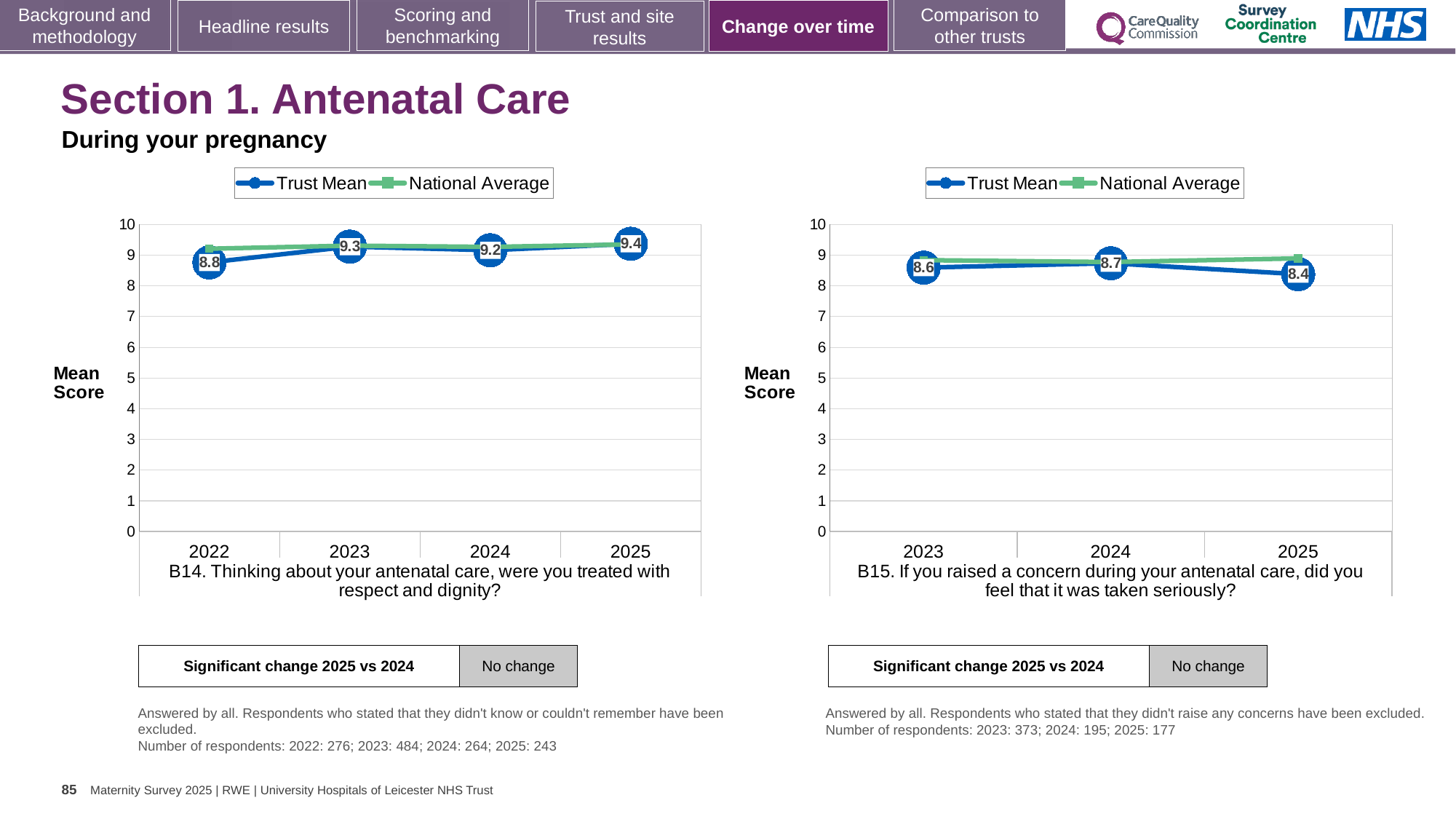
What kind of chart is the left chart (B14)? Line chart In the right chart (B15), what is the difference between the Trust Mean scores for 2024 and 2025? 0.3 In the left chart (B14), what is the Trust Mean score for 2022? 8.8 In the left chart (B14), which year has the highest Trust Mean score? 2025 In the right chart (B15), is the Trust Mean score for 2025 greater or less than 9? less In the right chart (B15), which year has the lowest Trust Mean score? 2025 In the left chart (B14), what is the difference between the Trust Mean scores for 2023 and 2022? 0.5 In the left chart (B14), how many years are plotted on the x axis? 4 In the left chart (B14), which year has the lowest Trust Mean score? 2022 In the right chart (B15), what is the Trust Mean score for 2024? 8.7 How many series does the legend of the right chart (B15) list? 2 In the left chart (B14), what is the Trust Mean score for 2025? 9.4